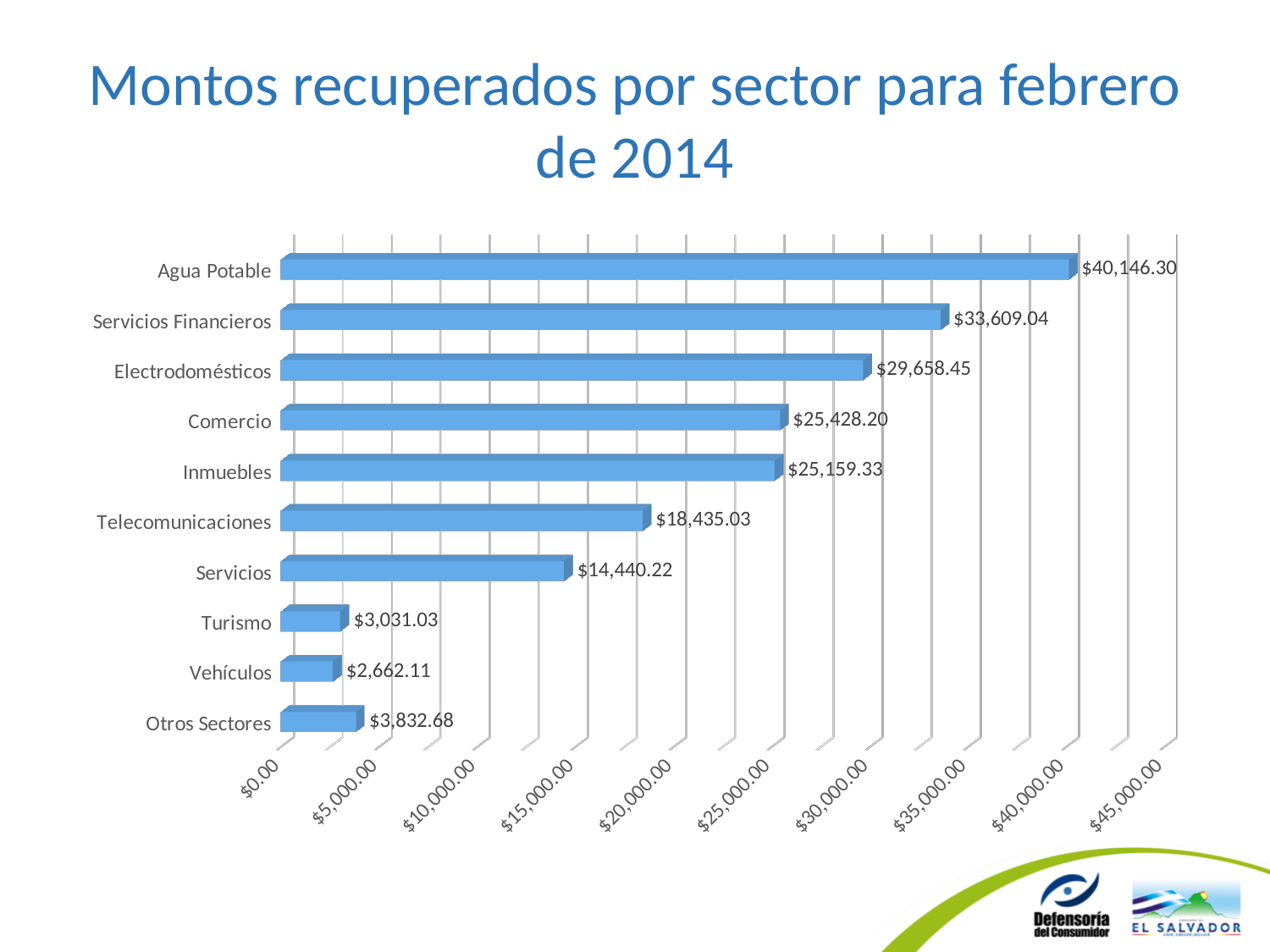
Which sector has the lowest recovered amount? Vehículos What is the difference between the values for Turismo and Vehículos? $368.92 What is the title of the chart? Montos recuperados por sector para febrero de 2014 Which is larger, the value for Comercio or the value for Inmuebles? Comercio What is the value for Otros Sectores? $3,832.68 Is the value for Electrodomésticos greater or less than $30,000.00? less How many sectors are shown in the chart? 10 What is the value for Agua Potable? $40,146.30 What is the value for Telecomunicaciones? $18,435.03 Which sector has the highest recovered amount? Agua Potable What kind of chart is shown on the slide? Bar chart What is the difference between the values for Agua Potable and Servicios Financieros? $6,537.26